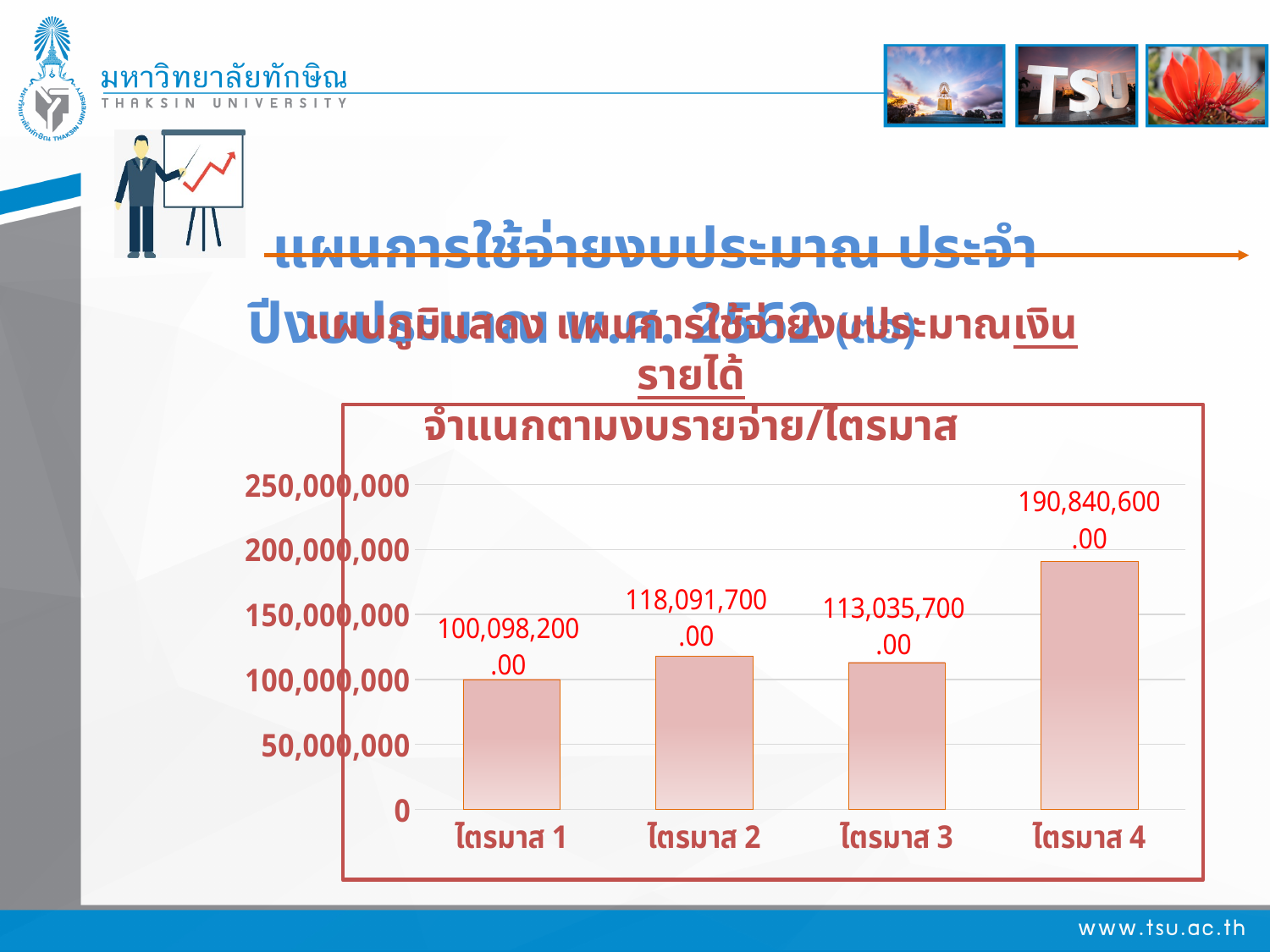
Which quarter has the lowest value? ไตรมาส 1 What is the difference between the values for ไตรมาส 2 and ไตรมาส 3? 5,056,000.00 What is the value for ไตรมาส 1? 100,098,200.00 What is the value for ไตรมาส 4? 190,840,600.00 What is the difference between the values for ไตรมาส 4 and ไตรมาส 1? 90,742,400.00 What is the value for ไตรมาส 3? 113,035,700.00 What is the highest value shown on the y axis? 250,000,000 What kind of chart is shown on the slide? bar chart Which quarter has the highest value? ไตรมาส 4 Is the value for ไตรมาส 4 greater or less than 150,000,000? greater Which is larger, the value for ไตรมาส 2 or ไตรมาส 3? ไตรมาส 2 How many quarters are shown on the x axis? 4